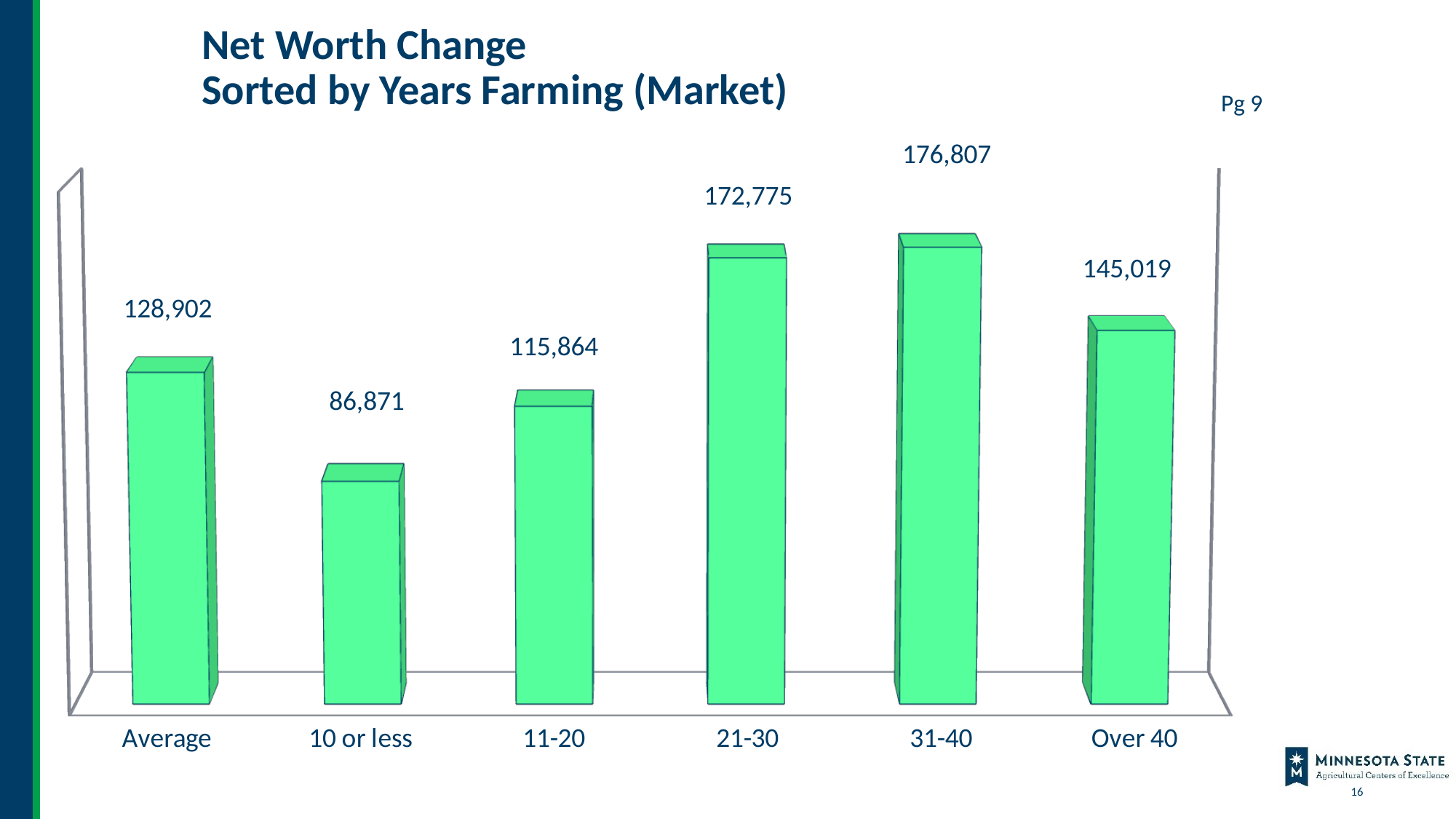
What is the Average net worth change shown on the chart? 128,902 What is the net worth change for the Over 40 group? 145,019 How many categories are shown on the chart? 6 What is the net worth change for the 10 or less years farming group? 86,871 What is the difference between the net worth change for 31-40 and 21-30? 4,032 Which years-farming group has the highest net worth change? 31-40 How much higher is the Average net worth change than that of the 10 or less group? 42,031 Which has a larger net worth change, 11-20 or Over 40? Over 40 Which years-farming group has the lowest net worth change? 10 or less What is the title of the chart? Net Worth Change Sorted by Years Farming (Market) What type of chart is shown on the slide? Bar chart What is the net worth change for the 21-30 years farming group? 172,775